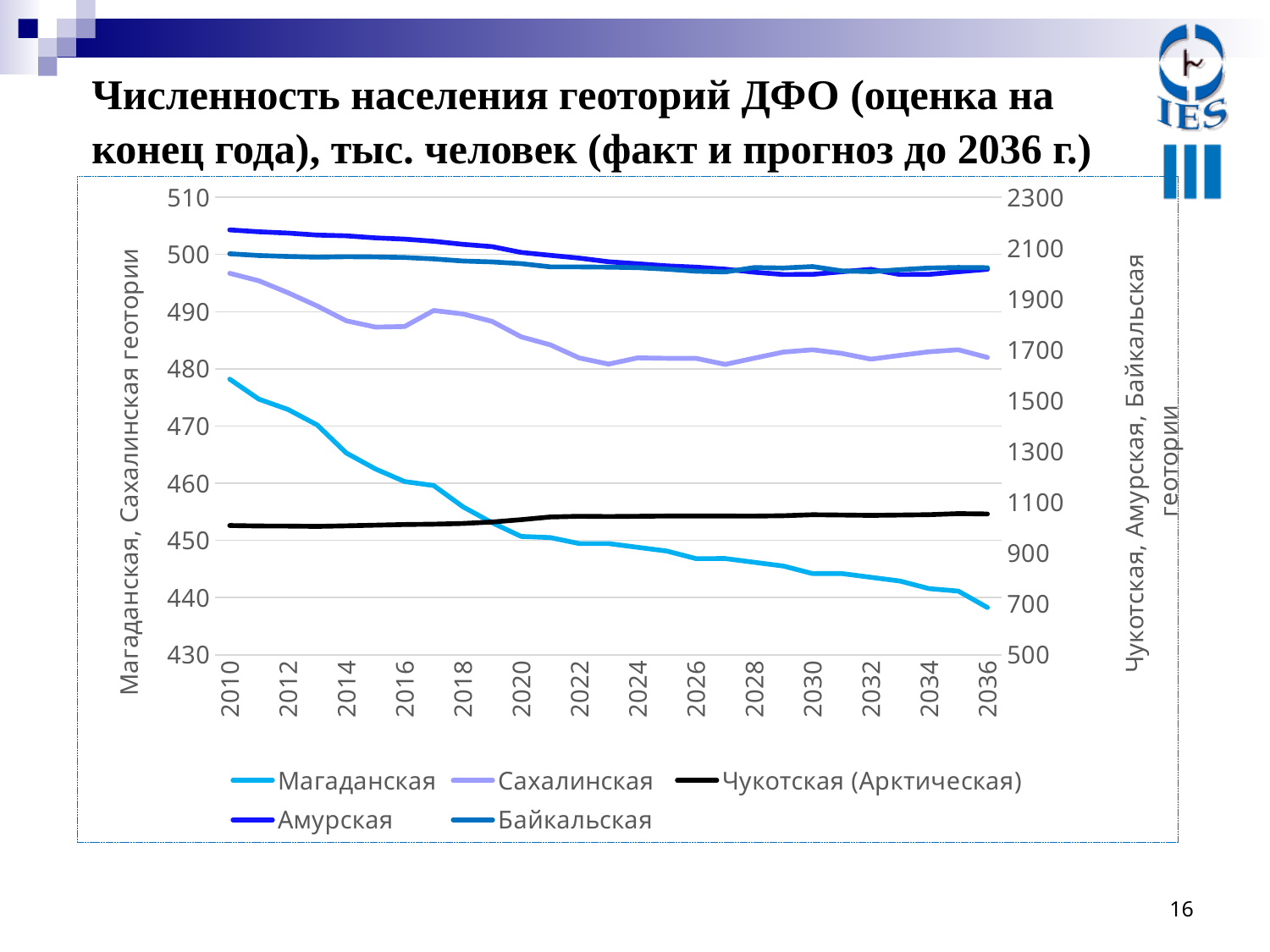
How many series does the legend list? 5 What kind of chart is shown on the slide? line chart Does the value for Амурская rise or fall from 2010 to 2036? fall Is the value for Амурская in 2010 greater or less than 2100? greater Does the value for Магаданская rise or fall from 2010 to 2036? fall What is the label of the left vertical axis? Магаданская, Сахалинская геотории Which is larger in 2036, the value for Магаданская or the value for Сахалинская? Сахалинская Is the value for Чукотская (Арктическая) in 2036 greater or less than 900? greater Is the value for Магаданская in 2010 greater or less than 470? greater Which of the series plotted on the right axis has the lowest values? Чукотская (Арктическая)